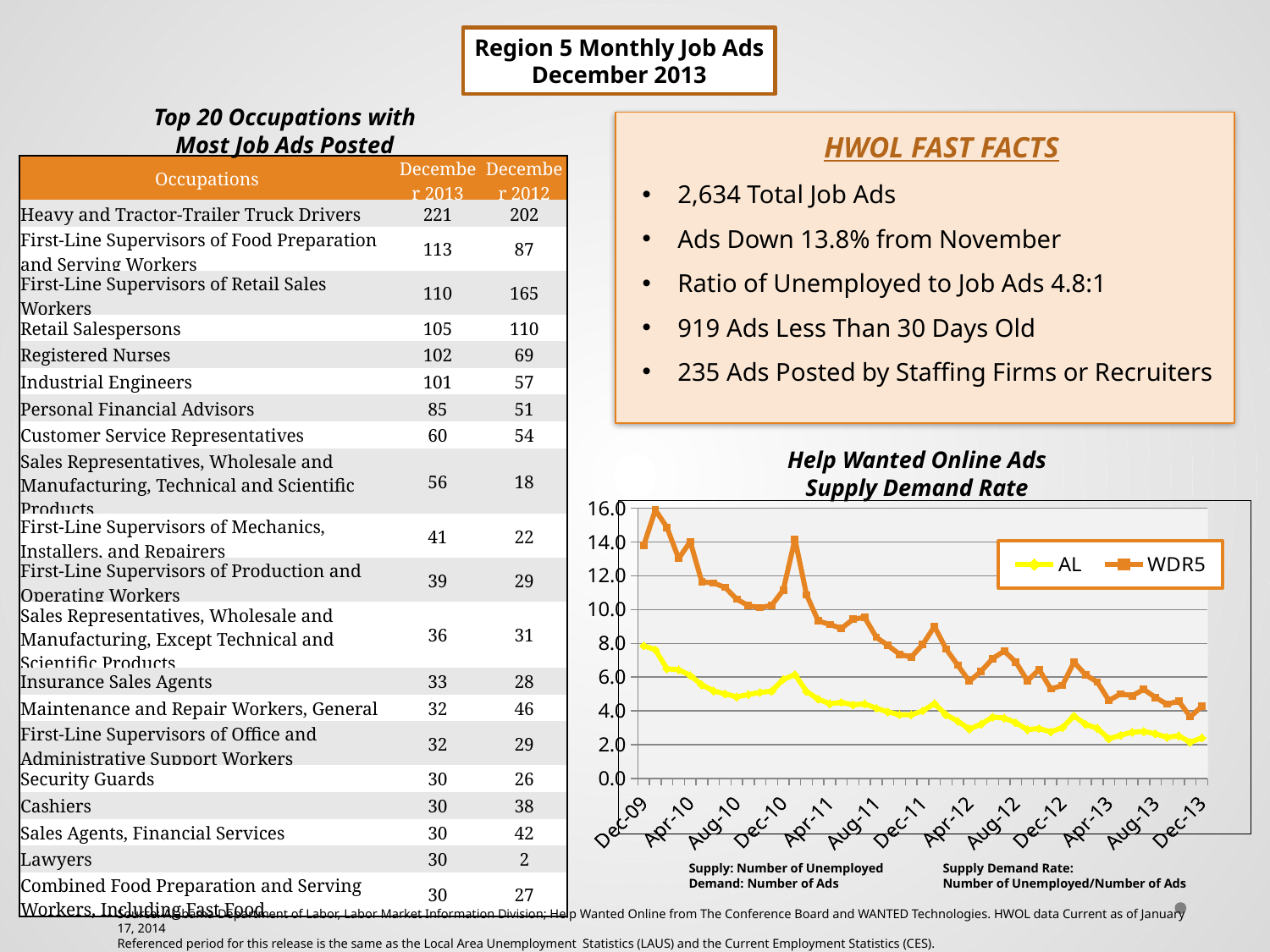
How many month labels are shown along the x axis of the "Help Wanted Online Ads Supply Demand Rate" chart? 13 In the "Help Wanted Online Ads Supply Demand Rate" chart, do the WDR5 values generally rise or fall from Dec-09 to Dec-13? fall In the "Help Wanted Online Ads Supply Demand Rate" chart, is the WDR5 value at Dec-09 greater or less than 12.0? greater In the "Help Wanted Online Ads Supply Demand Rate" chart, which series has the higher value at Dec-09, AL or WDR5? WDR5 What are the two series named in the legend of the "Help Wanted Online Ads Supply Demand Rate" chart? AL and WDR5 In the "Help Wanted Online Ads Supply Demand Rate" chart, which series is drawn in yellow? AL In the "Help Wanted Online Ads Supply Demand Rate" chart, is the WDR5 value at Dec-13 greater or less than 6.0? less What kind of chart is the "Help Wanted Online Ads Supply Demand Rate" chart? line chart In the "Help Wanted Online Ads Supply Demand Rate" chart, is the AL value at Dec-13 greater or less than 4.0? less In the "Help Wanted Online Ads Supply Demand Rate" chart, do the AL values generally rise or fall from Dec-09 to Dec-13? fall How many series does the legend of the "Help Wanted Online Ads Supply Demand Rate" chart list? 2